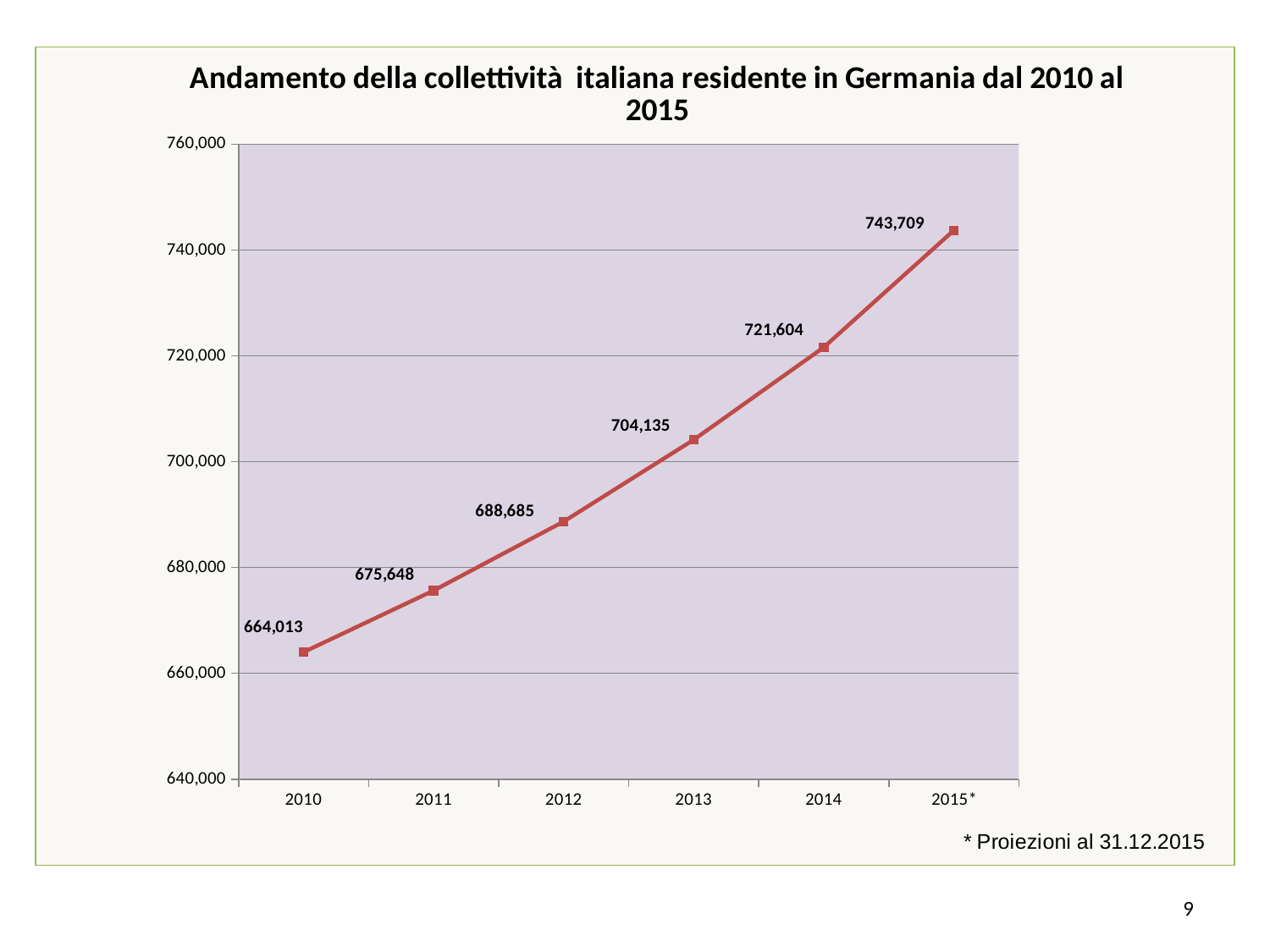
What is the value for 2010? 664,013 Do the values rise or fall from 2010 to 2015*? rise Is the value for 2014 greater or less than 720,000? greater Which year has the highest value? 2015* Which is larger, the value for 2012 or the value for 2011? 2012 What kind of chart is this? line chart What is the difference between the values for 2015* and 2010? 79,696 What is the difference between the values for 2014 and 2013? 17,469 What is the value for 2015*? 743,709 Which year has the lowest value? 2010 How many years are plotted on the chart? 6 What is the value for 2013? 704,135